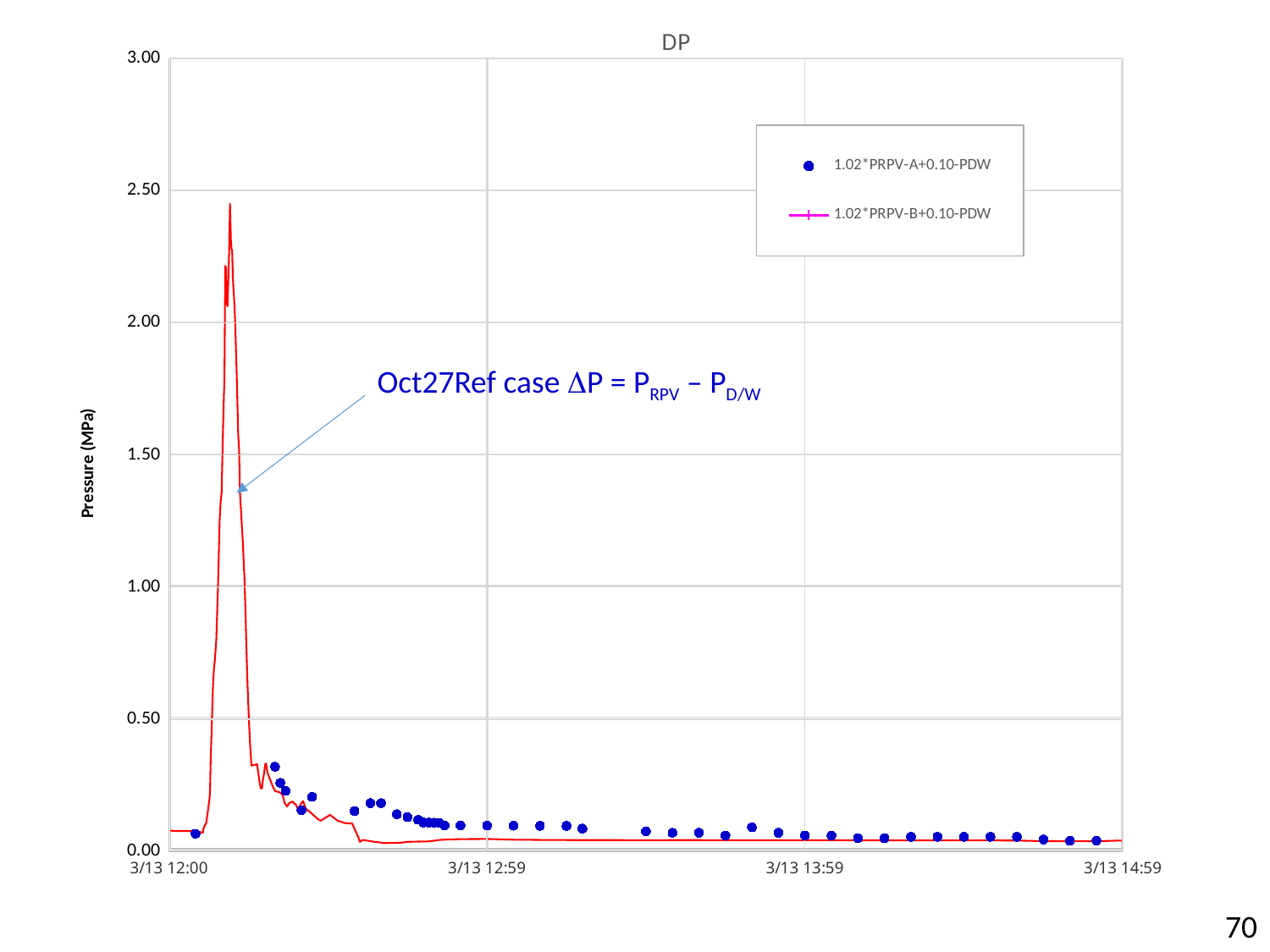
What is the highest value shown on the y axis? 3.00 Is the peak value of the red line greater or less than 2.00? greater After its peak, does the red line rise or fall as time moves toward 3/13 14:59? fall What is the label of the y axis? Pressure (MPa) Is the peak value of the red line greater or less than 2.50? less Do the blue dot values rise or fall from 3/13 12:59 to 3/13 14:59? fall What is the title of the chart? DP Is the value of the red line at 3/13 13:59 greater or less than 0.50? less What kind of chart is shown on the slide? line chart Which is larger: the peak of the red line or the highest blue dot value? the peak of the red line How many series does the legend list? 2